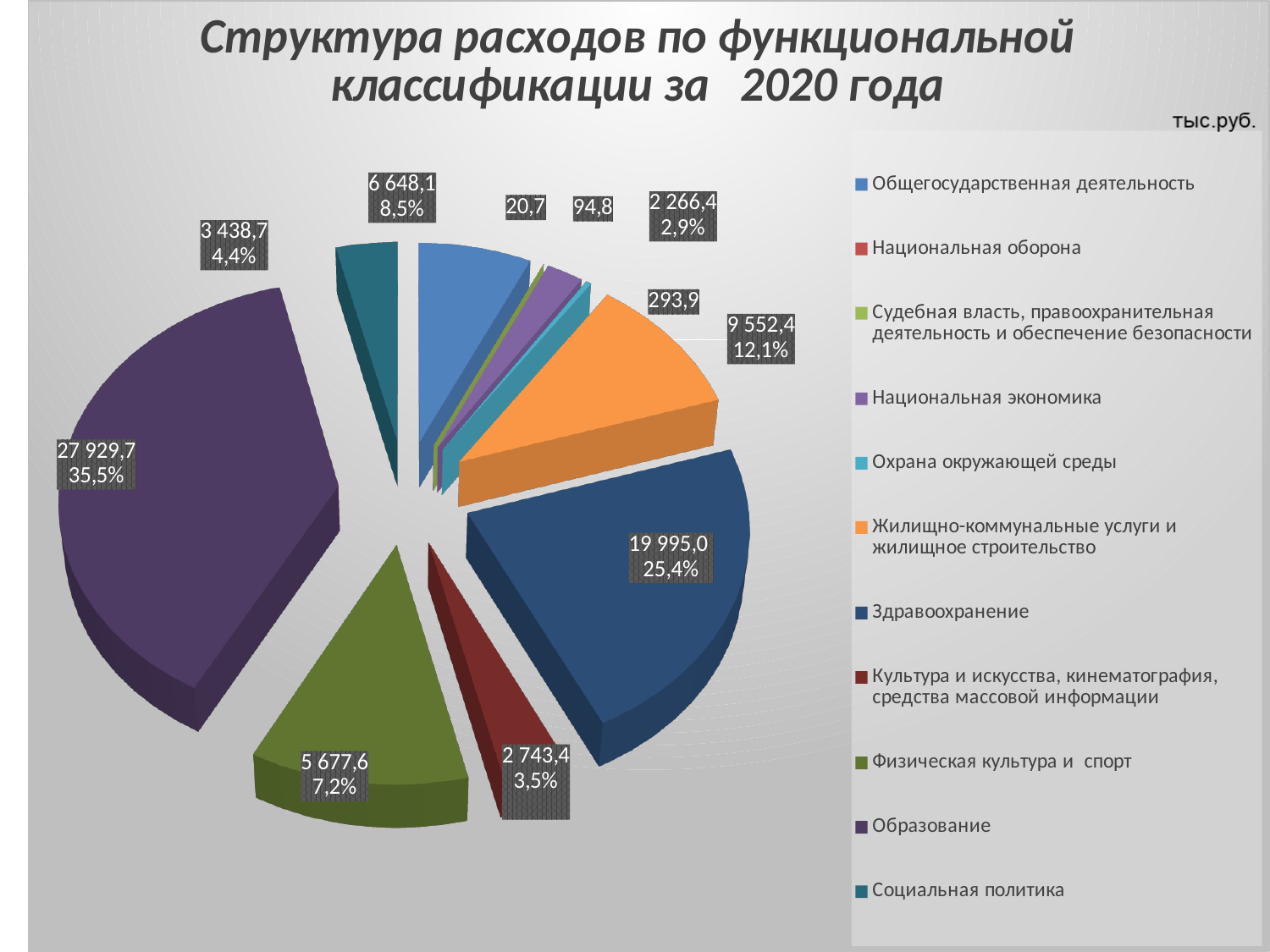
How many categories does the legend list? 11 Which is larger, the value for Физическая культура и спорт or the value for Общегосударственная деятельность? Общегосударственная деятельность What is the difference between the values for Образование and Здравоохранение? 7 934,7 What is the value for Жилищно-коммунальные услуги и жилищное строительство? 9 552,4 What share of the pie does Социальная политика represent? 4,4% Which category has the smallest value? Национальная оборона What is the value for Национальная оборона? 20,7 What kind of chart is shown on the slide? Pie chart Which category has the largest value? Образование What is the value for Образование? 27 929,7 What unit is indicated for the values on the chart? тыс.руб. What share of the pie does Здравоохранение represent? 25,4%